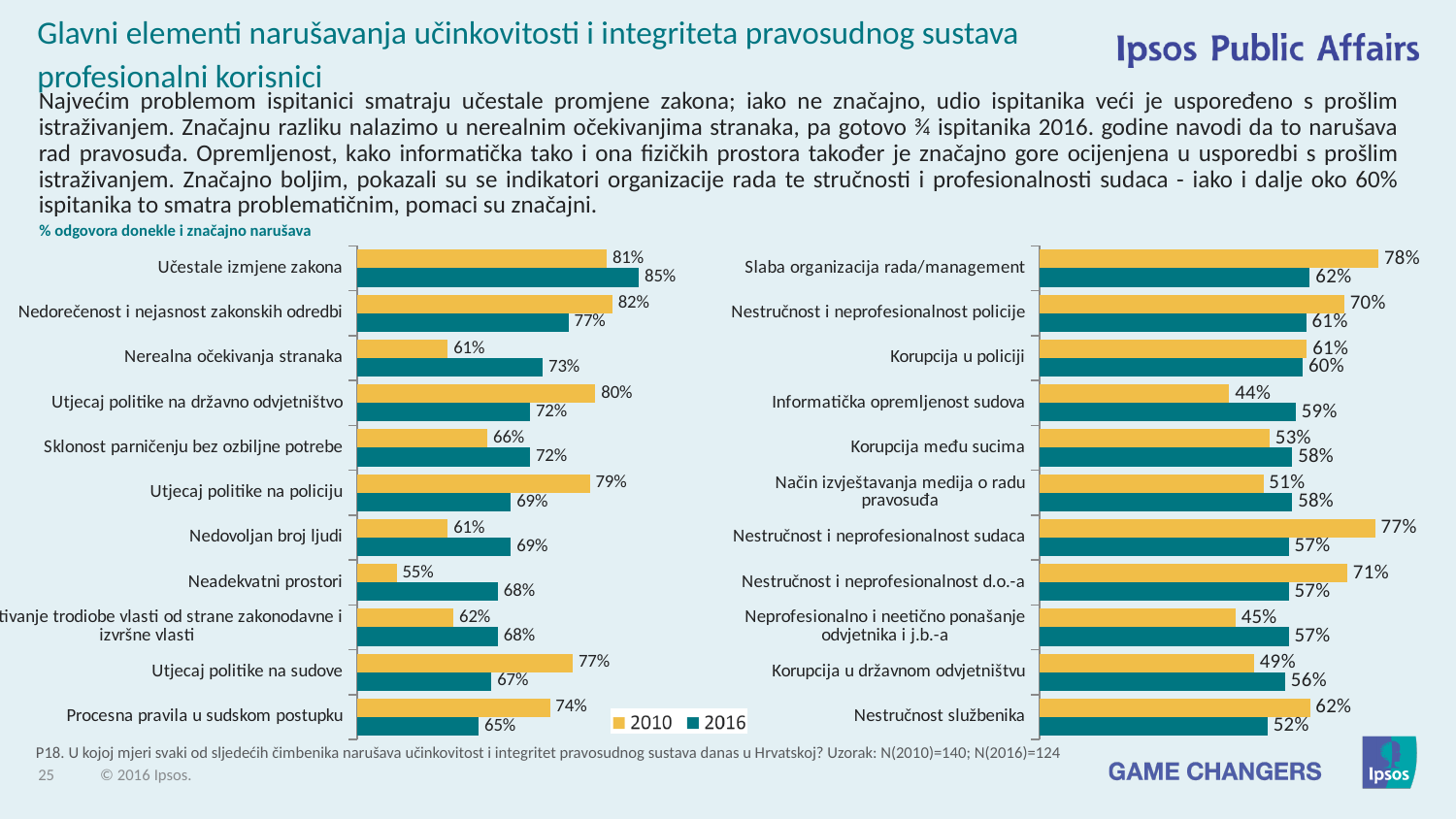
On the right chart, what is the 2010 value for Nestručnost i neprofesionalnost sudaca? 77% On the left chart, what is the 2010 value for Neadekvatni prostori? 55% How many categories are shown on the right chart? 11 On the left chart, what is the difference between the 2016 and 2010 values for Nerealna očekivanja stranaka? 12 percentage points How many series does the legend list? 2 On the left chart, what is the 2016 value for Učestale izmjene zakona? 85% On the right chart, which is larger for Korupcija među sucima: the 2010 value or the 2016 value? 2016 On the right chart, what is the difference between the 2010 and 2016 values for Slaba organizacija rada/management? 16 percentage points On the right chart, which category has the lowest 2010 value? Informatička opremljenost sudova What type of chart is the left chart? Bar chart On the left chart, which category has the highest 2016 value? Učestale izmjene zakona On the right chart, what is the 2016 value for Informatička opremljenost sudova? 59%